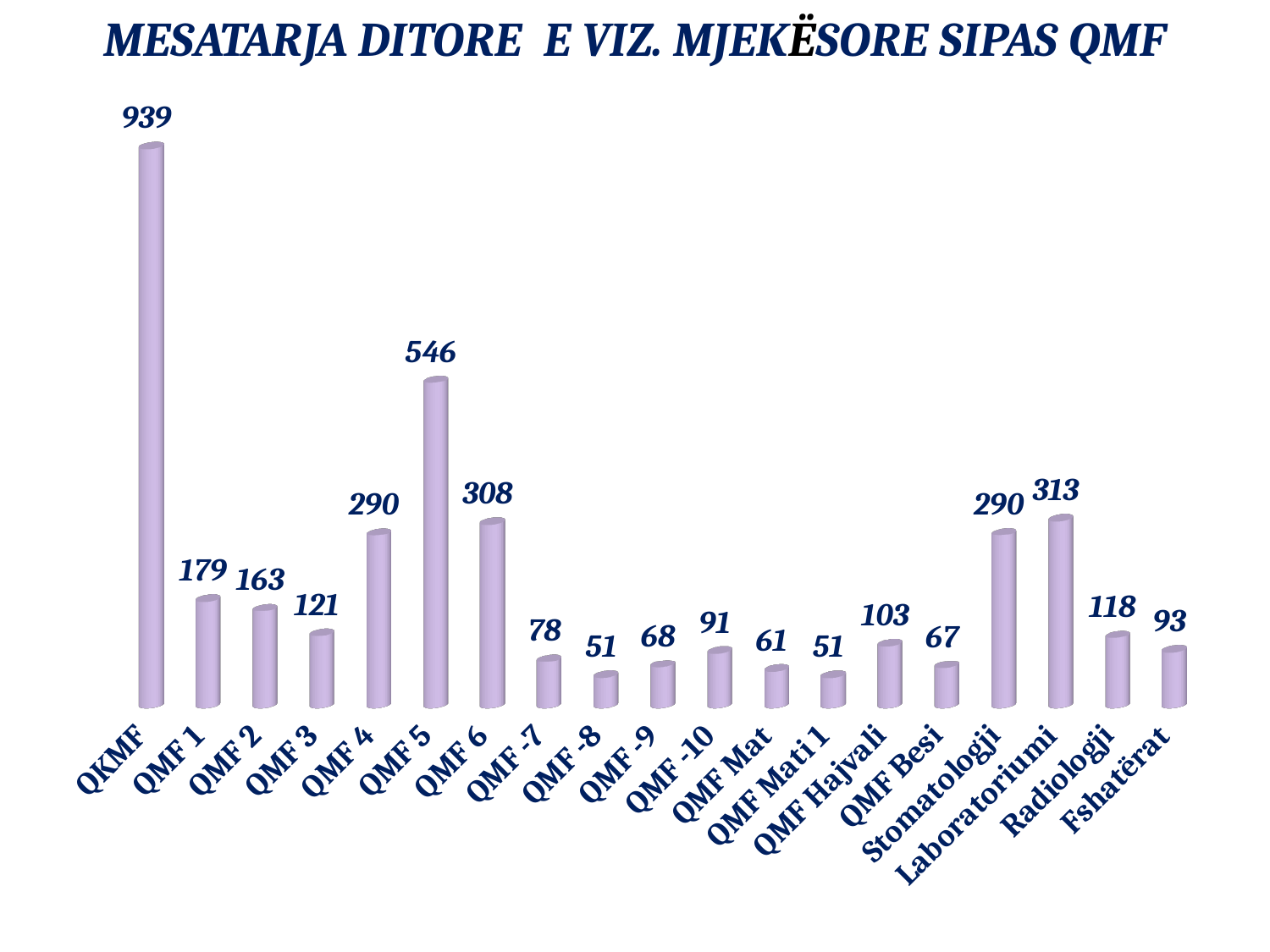
What kind of chart is shown on the slide? Bar chart Which category has the highest value? QKMF Which is larger, the value for QMF 2 or the value for QMF 3? QMF 2 What is the title of the chart? MESATARJA DITORE E VIZ. MJEKËSORE SIPAS QMF What is the value for QMF 5? 546 How many categories are shown on the chart? 19 What is the difference between the values for QMF 5 and QMF 6? 238 What is the difference between the values for QKMF and QMF 1? 760 Which is larger, the value for Radiologji or the value for Fshatërat? Radiologji What is the value for QMF Hajvali? 103 What is the value for Laboratoriumi? 313 What is the value for QKMF? 939